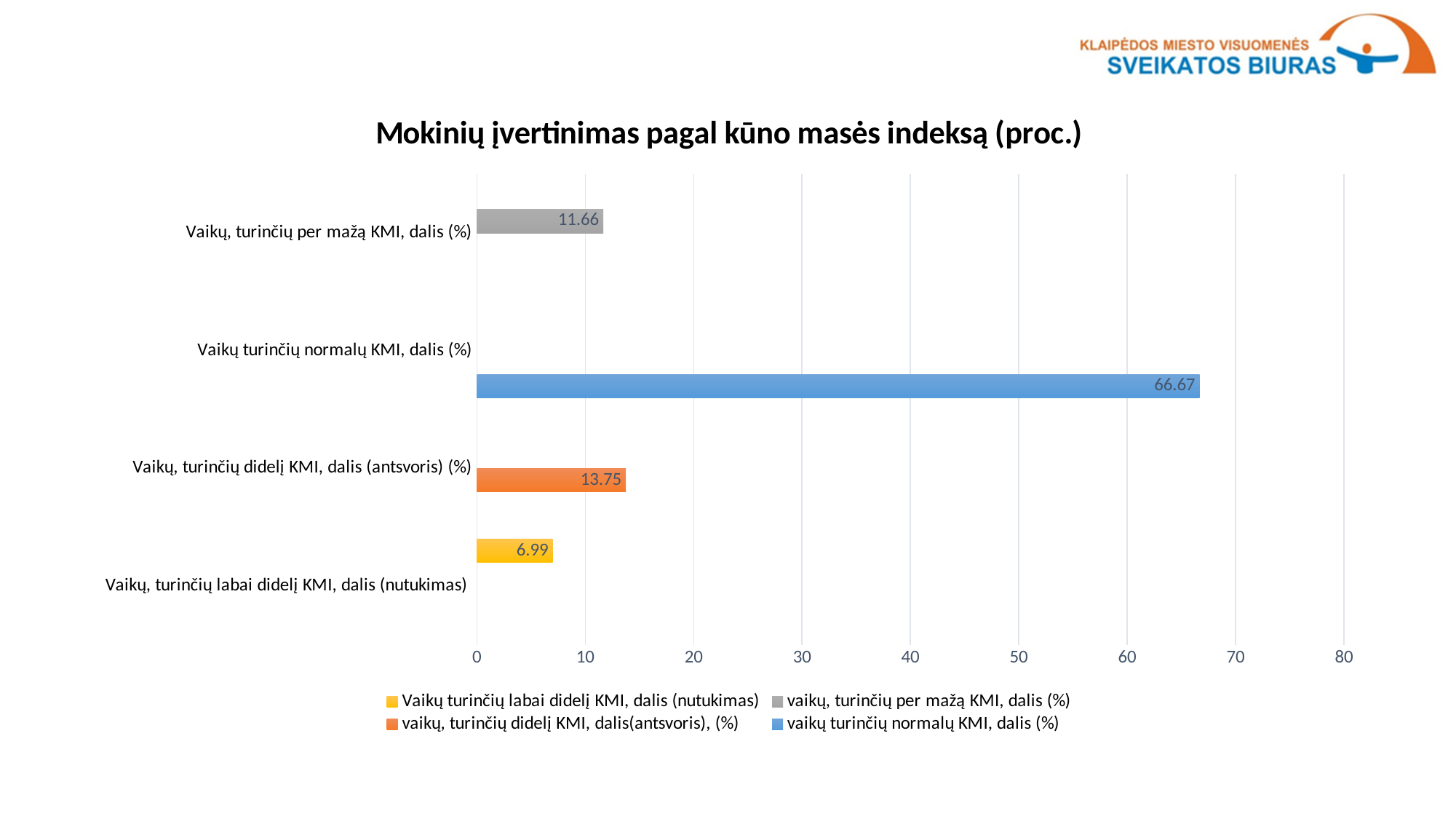
What is the value for 'Vaikų, turinčių per mažą KMI, dalis (%)'? 11.66 What is the value for 'Vaikų, turinčių labai didelį KMI, dalis (nutukimas)'? 6.99 Is the value for 'Vaikų turinčių normalų KMI, dalis (%)' greater or less than 60? greater Which is larger: the value for 'Vaikų, turinčių per mažą KMI, dalis (%)' or the value for 'Vaikų, turinčių labai didelį KMI, dalis (nutukimas)'? Vaikų, turinčių per mažą KMI, dalis (%) Which category has the lowest value? Vaikų, turinčių labai didelį KMI, dalis (nutukimas) What kind of chart is shown on the slide? bar chart What is the difference between the value for 'Vaikų, turinčių didelį KMI, dalis (antsvoris) (%)' and the value for 'Vaikų, turinčių per mažą KMI, dalis (%)'? 2.09 Which category has the highest value? Vaikų turinčių normalų KMI, dalis (%) How many series does the legend list? 4 How many categories are shown on the chart? 4 What is the value for 'Vaikų turinčių normalų KMI, dalis (%)'? 66.67 What is the value for 'Vaikų, turinčių didelį KMI, dalis (antsvoris) (%)'? 13.75